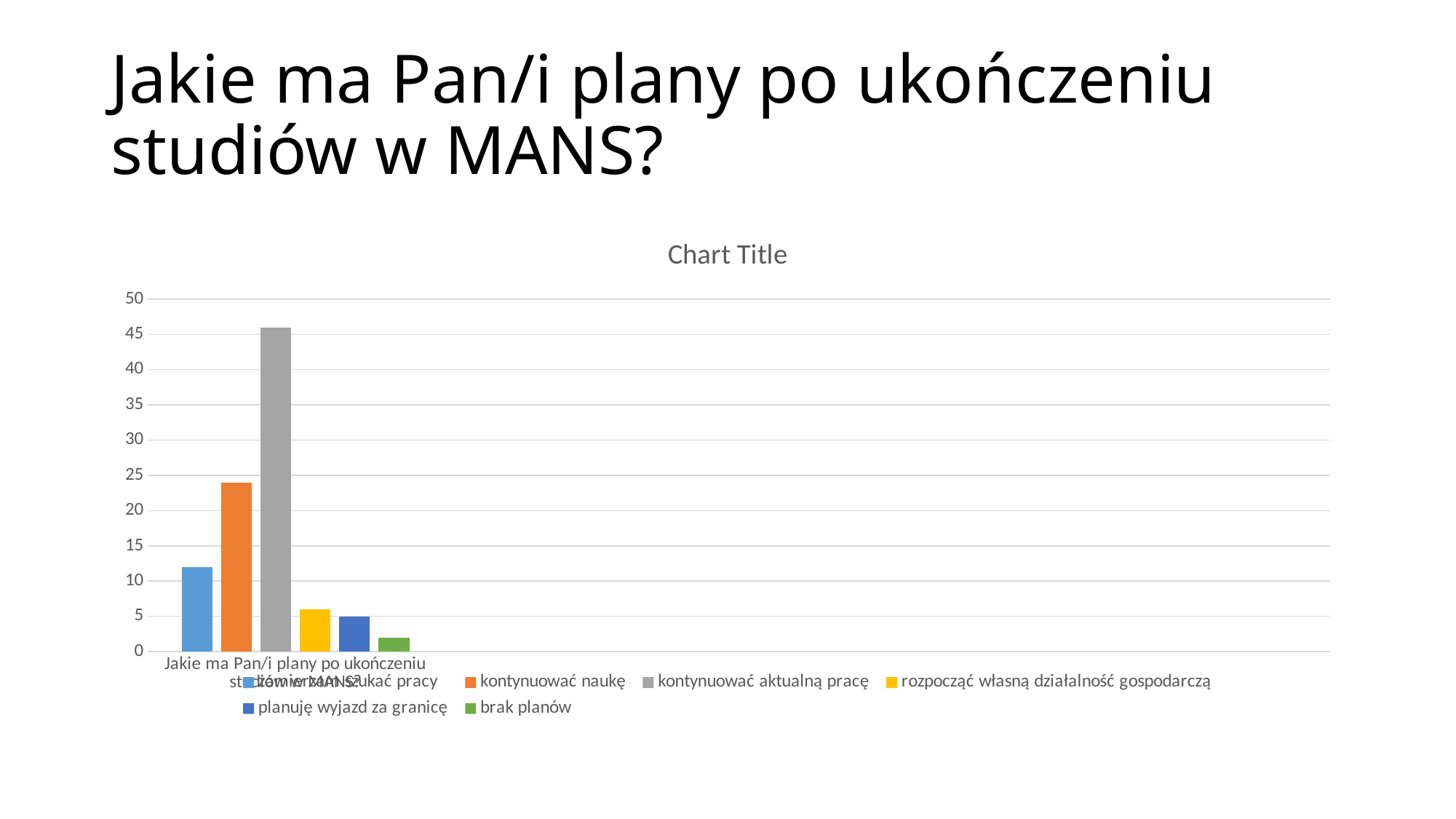
Which series has the lowest bar? brak planów Is the value for kontynuować aktualną pracę greater or less than 40? greater What is the title shown above the chart? Chart Title What colour is the bar for kontynuować aktualną pracę? gray Which series has the highest bar? kontynuować aktualną pracę Is the value for kontynuować naukę greater or less than 20? greater What kind of chart is shown on the slide? bar chart Is the value for brak planów greater or less than 5? less Which is larger, the value for kontynuować aktualną pracę or the value for kontynuować naukę? kontynuować aktualną pracę Which is larger, the value for kontynuować naukę or the value for rozpocząć własną działalność gospodarczą? kontynuować naukę How many series does the legend list? 6